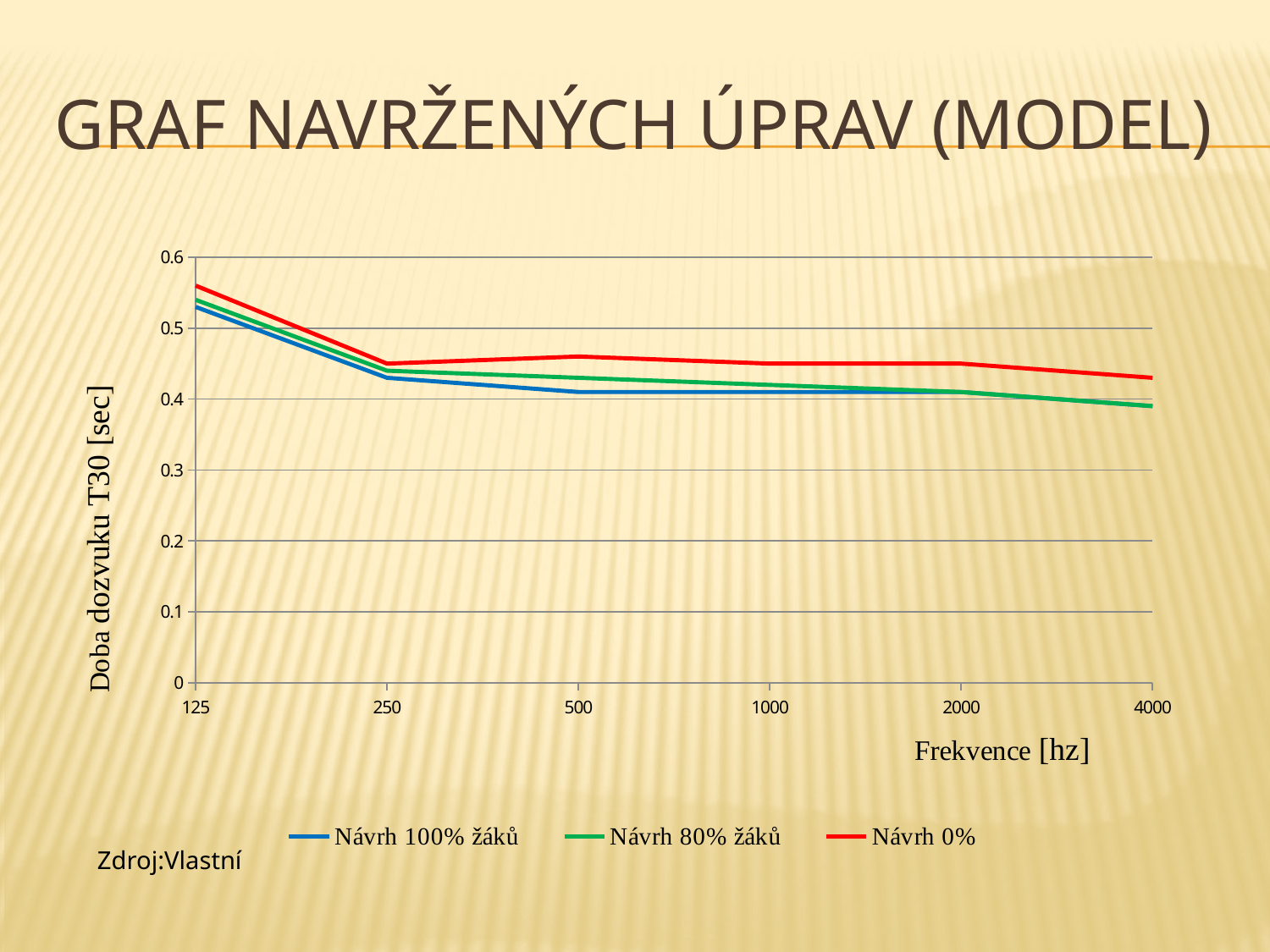
Is the value for Návrh 0% at 4000 Hz greater or less than 0.4? greater Which series has the highest value at 2000 Hz? Návrh 0% Do the values for Návrh 100% žáků generally rise or fall as frequency increases? fall Is the value for Návrh 0% at 125 Hz greater or less than 0.5? greater What is the label of the vertical axis? Doba dozvuku T30 [sec] At 125 Hz, which series has the larger value: Návrh 0% or Návrh 100% žáků? Návrh 0% How many frequency points are plotted along the x axis? 6 Is the value for Návrh 80% žáků at 1000 Hz greater or less than 0.5? less At which frequency does Návrh 0% reach its highest value? 125 How many series does the legend list? 3 What kind of chart is shown on the slide? line chart